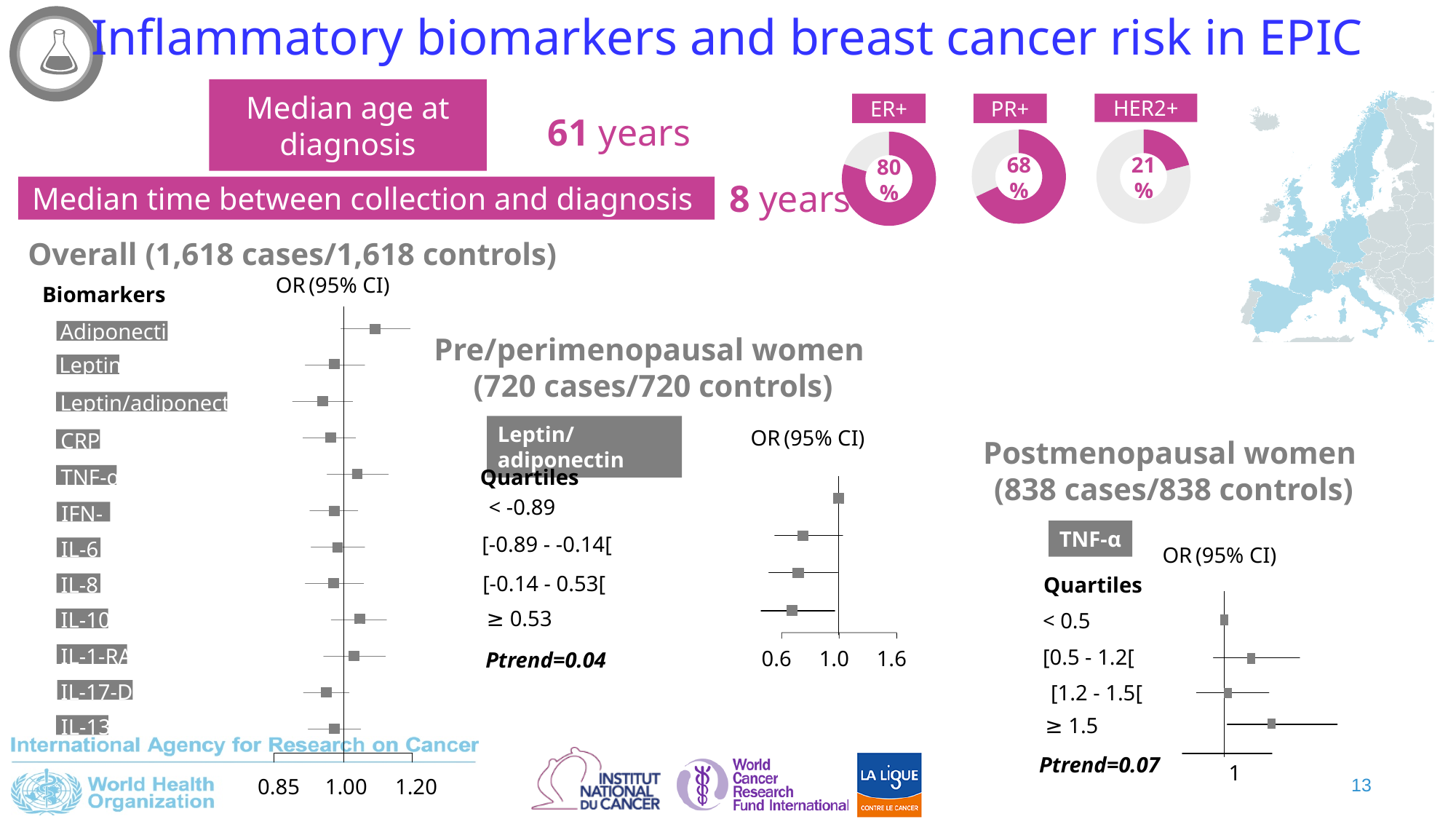
In the Overall forest plot, how many biomarkers are listed? 12 What is the difference in percentage points between the ER+ and PR+ doughnut charts? 12 In the ER+ doughnut chart, what percentage is shown? 80% In the Pre/perimenopausal women forest plot, is the OR for the ≥ 0.53 quartile greater or less than 1.0? less In the Postmenopausal women forest plot, is the OR for the ≥ 1.5 TNF-α quartile greater or less than 1? greater In the HER2+ doughnut chart, what percentage is shown? 21% Among the ER+, PR+ and HER2+ doughnut charts, which shows the highest percentage? ER+ What kind of chart is used to show the ER+, PR+ and HER2+ percentages? doughnut chart In the Pre/perimenopausal women forest plot, how many leptin/adiponectin quartiles are plotted? 4 Among the ER+, PR+ and HER2+ doughnut charts, which shows the lowest percentage? HER2+ In the Overall forest plot, is the OR for Adiponectin greater or less than 1.00? greater